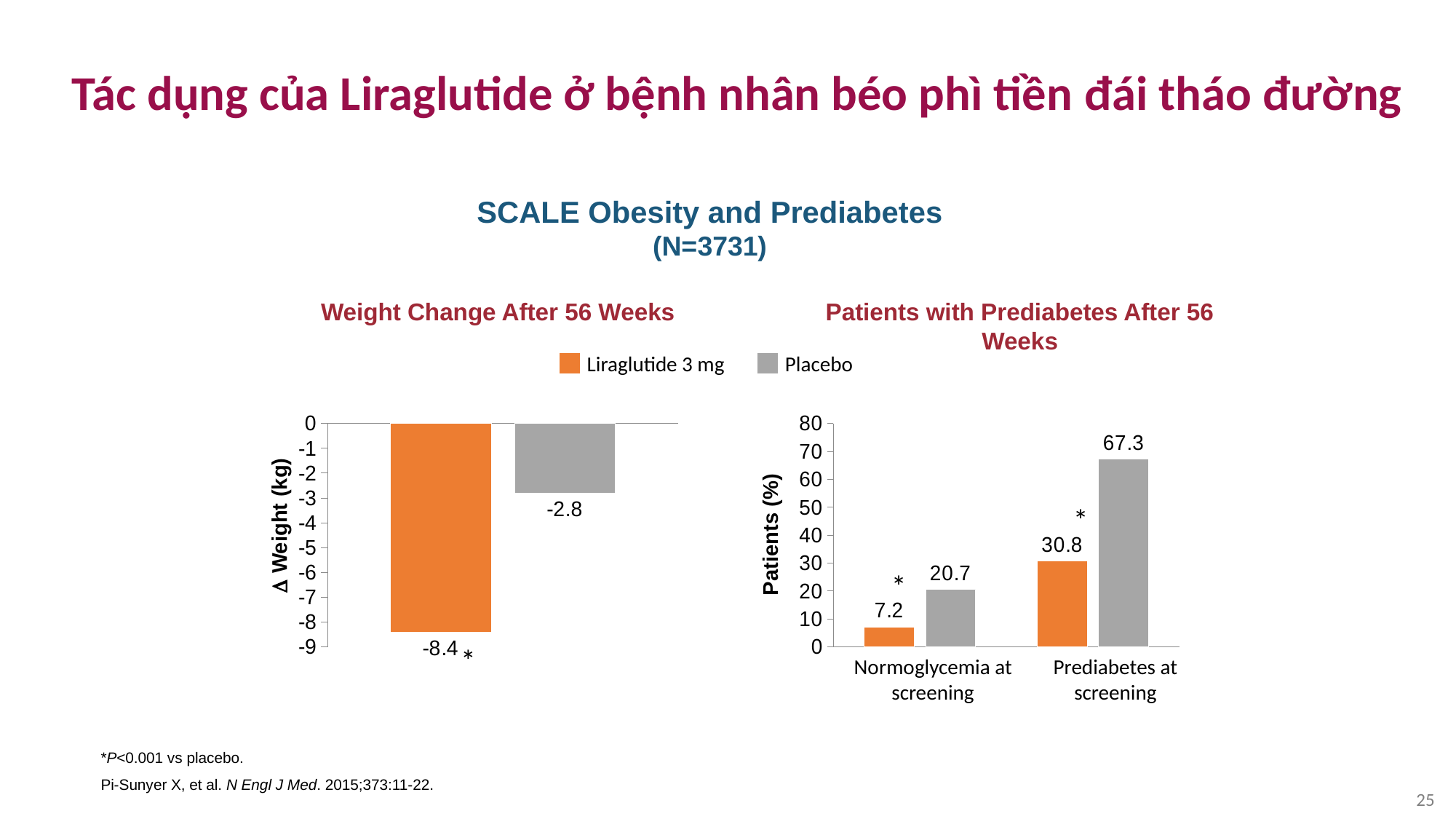
In the 'Patients with Prediabetes After 56 Weeks' chart, what is the difference between Placebo and Liraglutide 3 mg for patients with prediabetes at screening? 36.5 How many series does the shared legend list? 2 What type of chart is the 'Weight Change After 56 Weeks' chart? Bar chart In the 'Patients with Prediabetes After 56 Weeks' chart, what is the Placebo value for patients with prediabetes at screening? 67.3 In the 'Weight Change After 56 Weeks' chart, what is the weight change for Liraglutide 3 mg? -8.4 In the 'Weight Change After 56 Weeks' chart, which group shows the larger weight loss? Liraglutide 3 mg In the 'Patients with Prediabetes After 56 Weeks' chart, which bar is the highest? Placebo, Prediabetes at screening In the 'Weight Change After 56 Weeks' chart, what is the weight change for Placebo? -2.8 In the 'Patients with Prediabetes After 56 Weeks' chart, what percentage of Liraglutide 3 mg patients with normoglycemia at screening had prediabetes? 7.2 In the 'Weight Change After 56 Weeks' chart, what is the difference between the Placebo and Liraglutide 3 mg weight changes? 5.6 In the 'Patients with Prediabetes After 56 Weeks' chart, what is the Liraglutide 3 mg value for patients with prediabetes at screening? 30.8 In the 'Patients with Prediabetes After 56 Weeks' chart, how many categories are shown on the x axis? 2